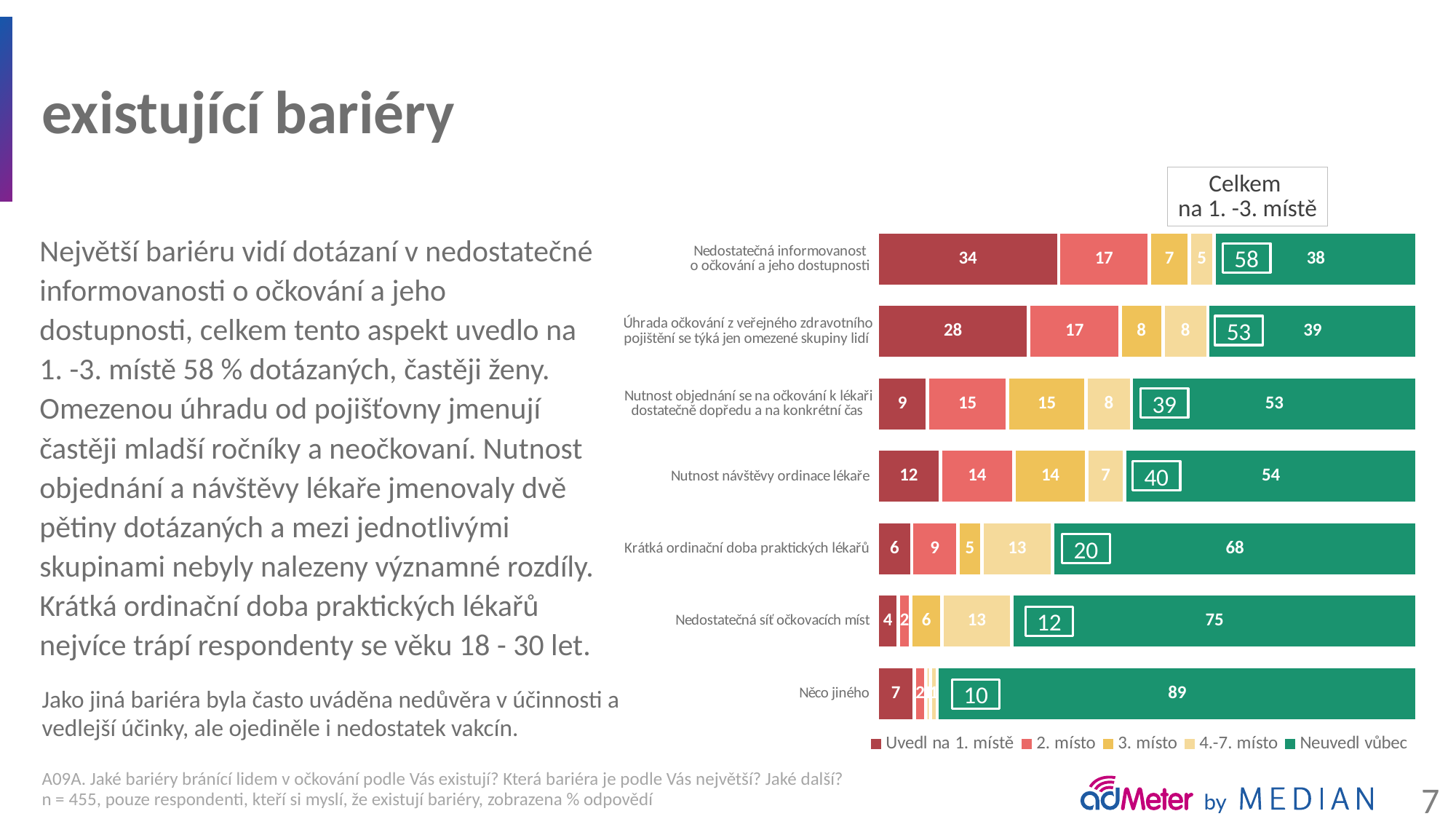
What value is shown for "Neuvedl vůbec" for "Něco jiného"? 89 What value is shown for "4.-7. místo" for "Krátká ordinační doba praktických lékařů"? 13 What is the "Celkem na 1. -3. místě" value for "Úhrada očkování z veřejného zdravotního pojištění se týká jen omezené skupiny lidí"? 53 Which is larger: the "2. místo" value for "Nutnost objednání se na očkování k lékaři dostatečně dopředu a na konkrétní čas" or for "Nutnost návštěvy ordinace lékaře"? Nutnost objednání se na očkování k lékaři dostatečně dopředu a na konkrétní čas What is the sum of the "Uvedl na 1. místě", "2. místo" and "3. místo" values for "Nutnost návštěvy ordinace lékaře"? 40 What value is shown for "Uvedl na 1. místě" for "Nedostatečná informovanost o očkování a jeho dostupnosti"? 34 How many series does the legend list? 5 Which category has the lowest "Neuvedl vůbec" value? Nedostatečná informovanost o očkování a jeho dostupnosti Which category has the highest "Uvedl na 1. místě" value? Nedostatečná informovanost o očkování a jeho dostupnosti What kind of chart is shown on the slide? Stacked bar chart How many categories (barriers) are shown in the chart? 7 What is the difference between the "Neuvedl vůbec" values for "Nedostatečná síť očkovacích míst" and "Krátká ordinační doba praktických lékařů"? 7